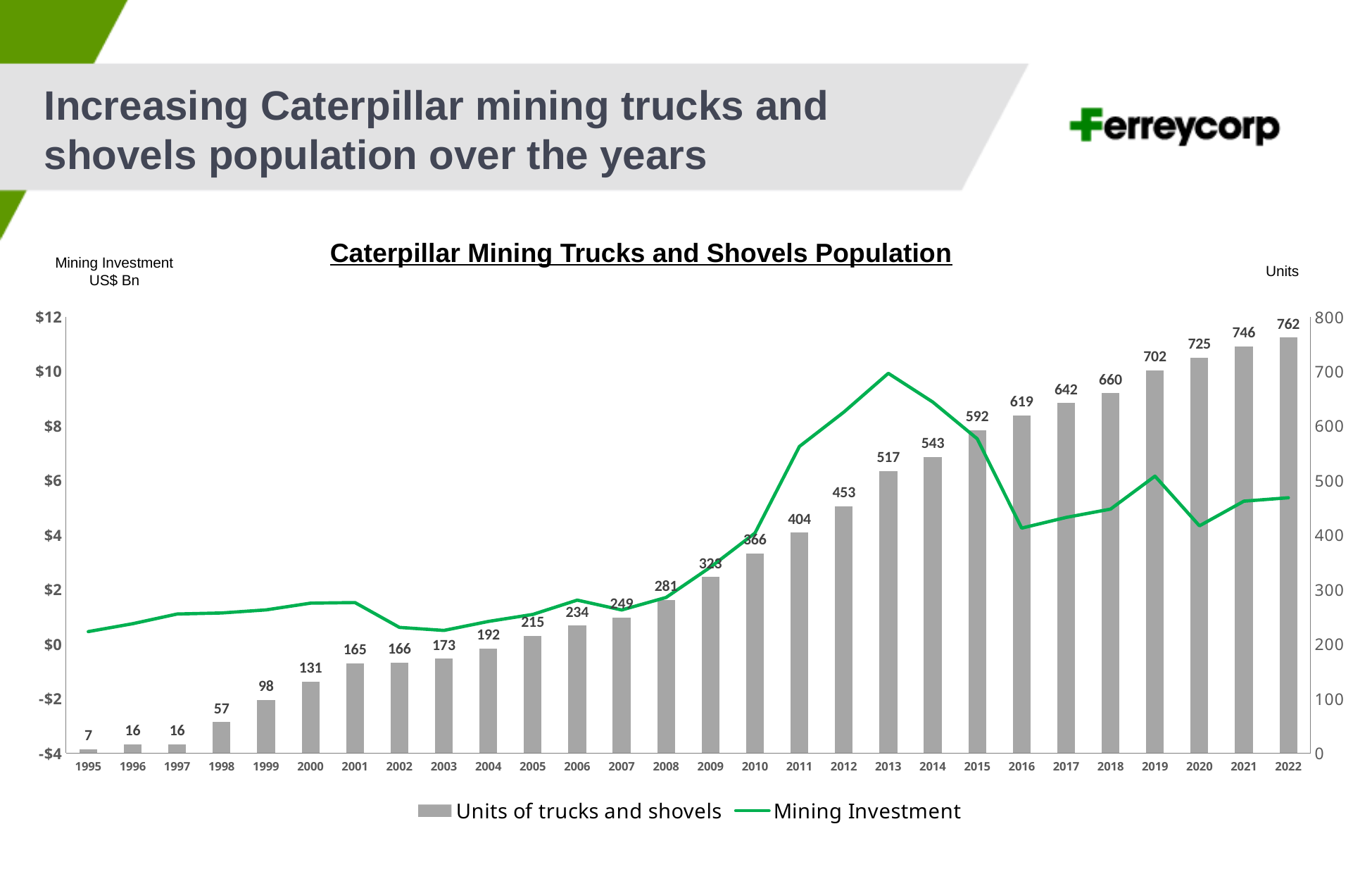
Is the Mining Investment value for 2013 greater or less than $8? greater What is the difference in units of trucks and shovels between 2022 and 2021? 16 What kind of chart is shown on the slide? Combined bar and line chart Which year has the lowest number of units of trucks and shovels? 1995 What is the value for Units of trucks and shovels in 2013? 517 Which year has the highest number of units of trucks and shovels? 2022 How many units of trucks and shovels are shown for 2000? 131 How many series does the legend list? 2 Which year has more units of trucks and shovels, 2012 or 2016? 2016 What is the value for Units of trucks and shovels in 2022? 762 How many years are shown on the x axis of the chart? 28 Do the units of trucks and shovels rise or fall from 1995 to 2022? Rise